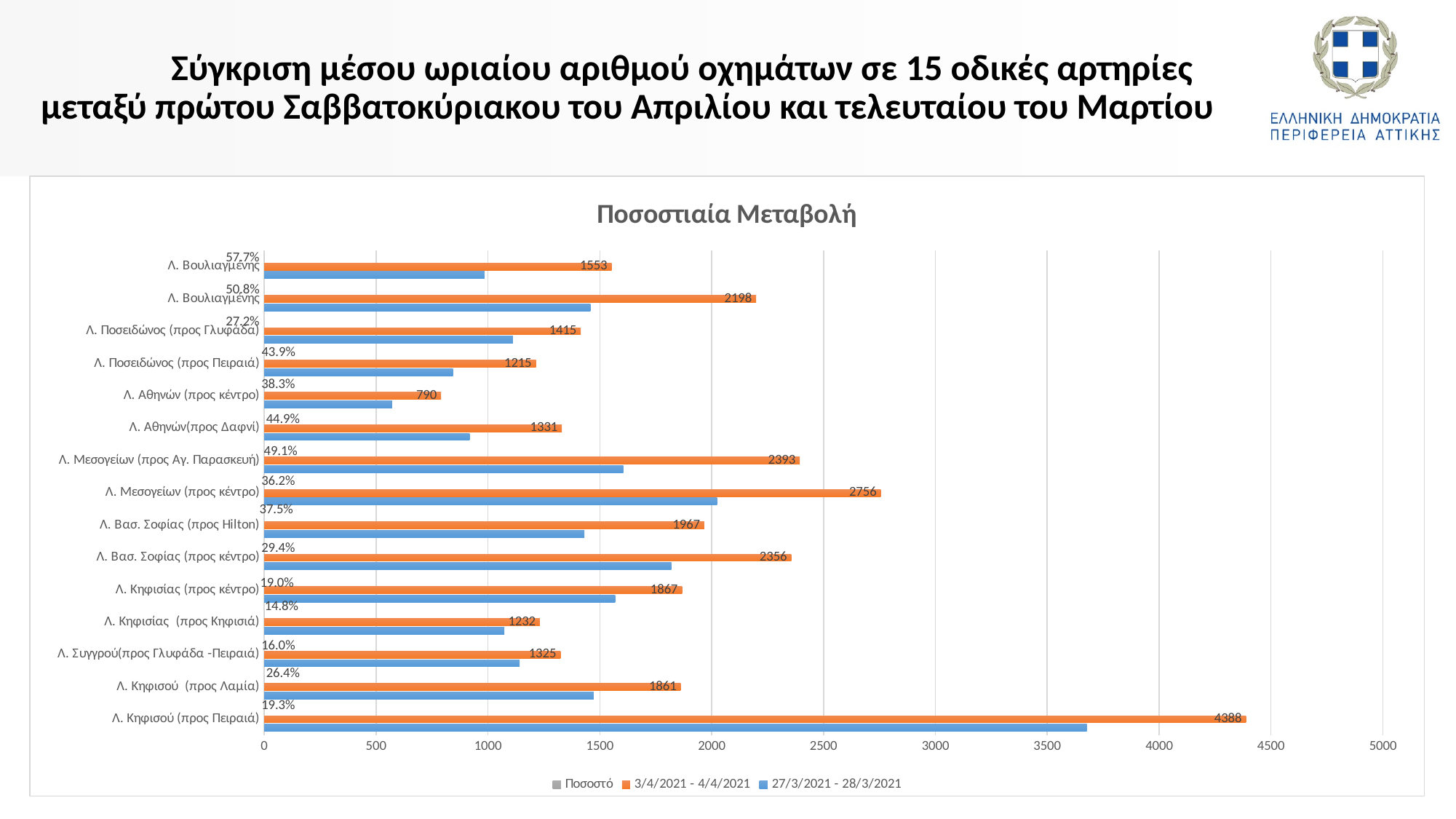
Which category has the highest 3/4/2021 - 4/4/2021 value? Λ. Κηφισού (προς Πειραιά) What kind of chart is shown on the slide? bar chart What is the difference between the 3/4/2021 - 4/4/2021 values for Λ. Μεσογείων (προς κέντρο) and Λ. Μεσογείων (προς Αγ. Παρασκευή)? 363 What percentage change is shown for Λ. Ποσειδώνος (προς Πειραιά)? 43.9% What is the title of the chart? Ποσοστιαία Μεταβολή Is the 27/3/2021 - 28/3/2021 value for Λ. Αθηνών (προς κέντρο) greater or less than 1000? less Is the 27/3/2021 - 28/3/2021 value for Λ. Κηφισού (προς Πειραιά) greater or less than 3500? greater How many series does the chart legend list? 3 How many road arteries (categories) are plotted in the chart? 15 Which has the larger 3/4/2021 - 4/4/2021 value: Λ. Βασ. Σοφίας (προς κέντρο) or Λ. Βασ. Σοφίας (προς Hilton)? Λ. Βασ. Σοφίας (προς κέντρο) What is the 3/4/2021 - 4/4/2021 value for Λ. Κηφισού (προς Πειραιά)? 4388 Which category has the lowest 3/4/2021 - 4/4/2021 value? Λ. Αθηνών (προς κέντρο)